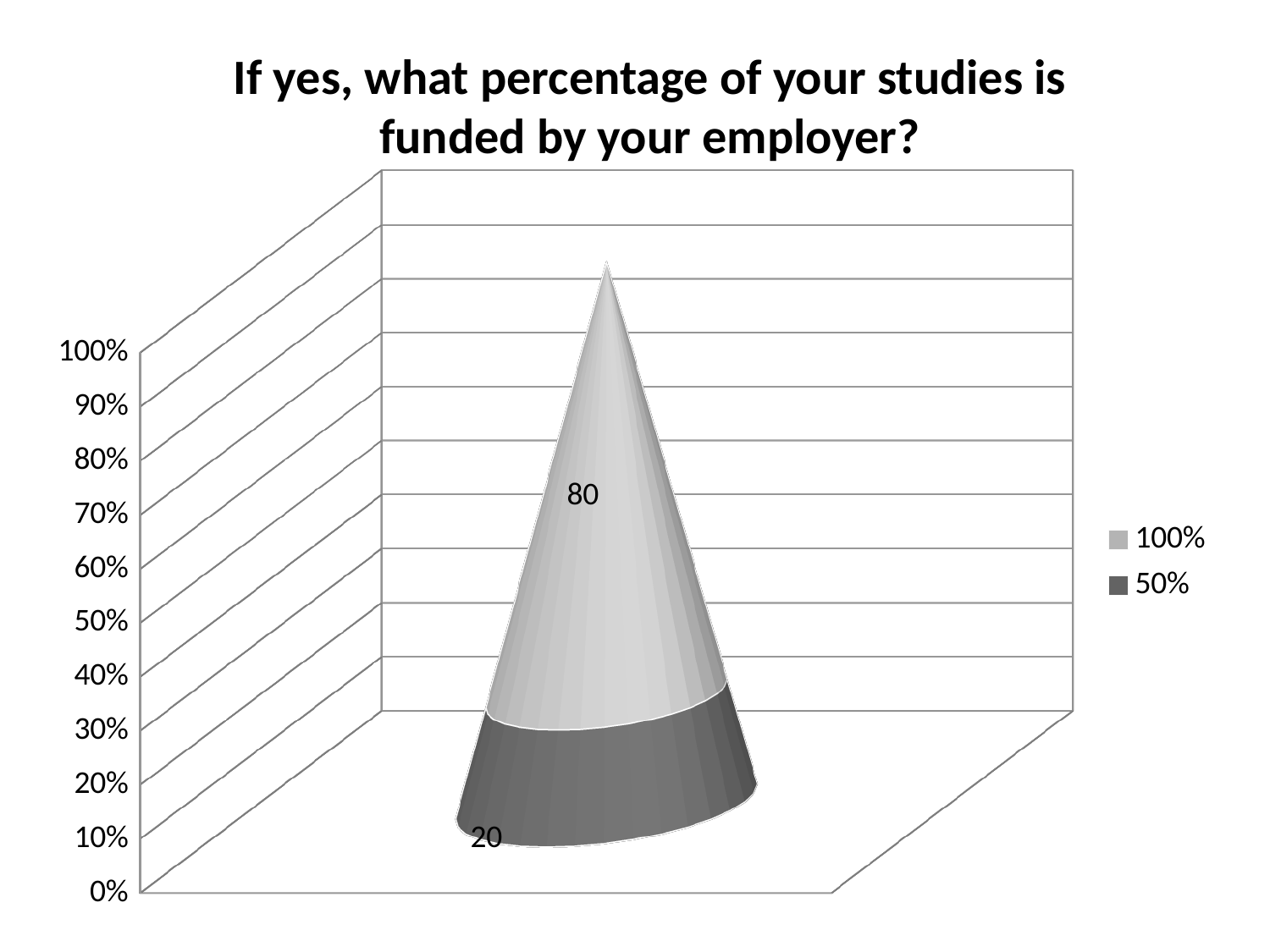
What is the data label for the "100%" series? 80 What is the total of the two stacked segments? 100 Which series has the largest value? 100% How many series does the legend list? 2 What kind of chart is shown on the slide? Stacked bar chart Which series has the larger value, "100%" or "50%"? 100% What is the difference between the values of the "100%" series and the "50%" series? 60 Which series is shown in the darker shade at the bottom of the stack? 50% What is the data label for the "50%" series? 20 Which series has the smallest value? 50% What is the title of the chart? If yes, what percentage of your studies is funded by your employer?